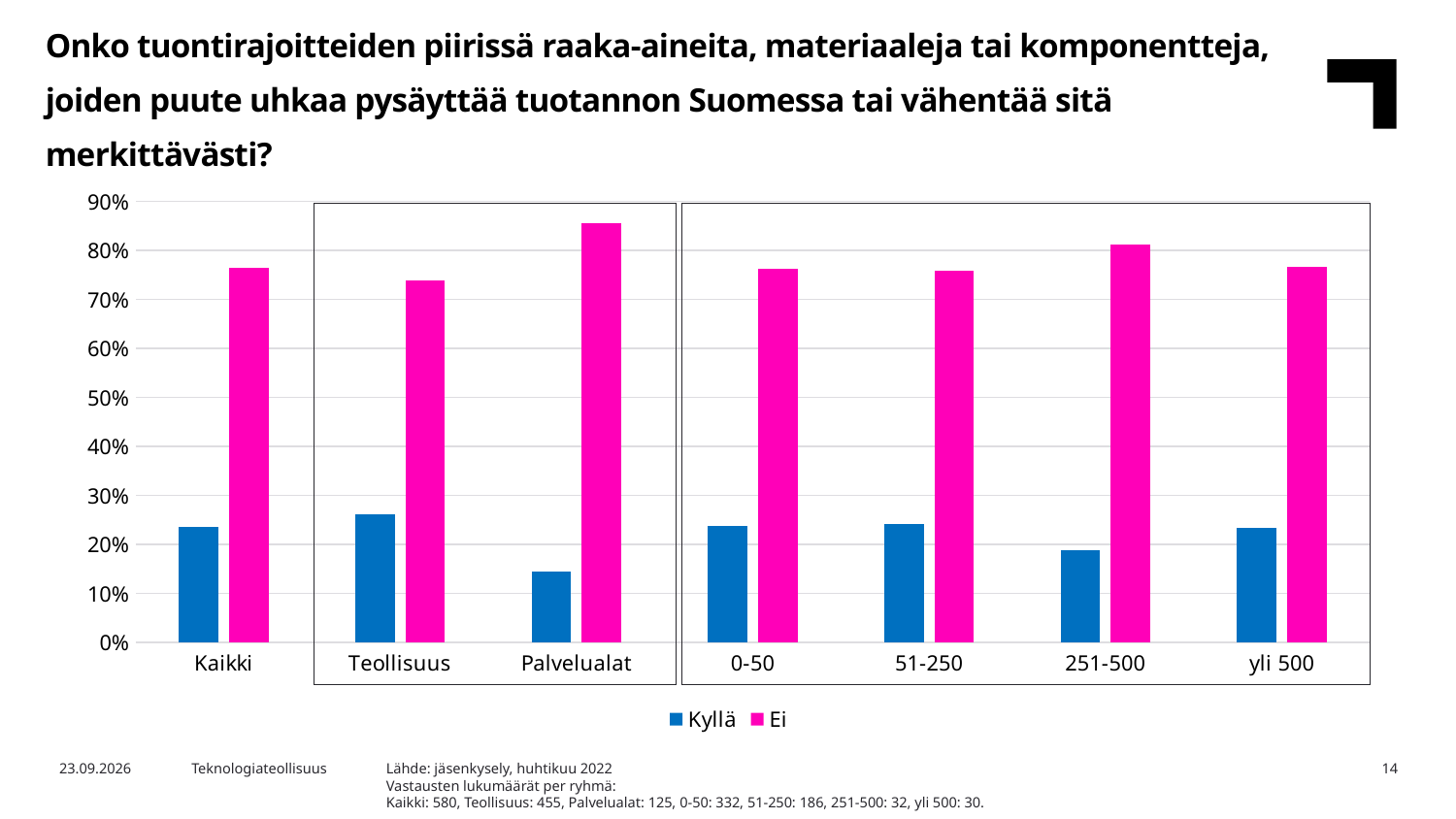
Is the Ei value for 251-500 greater or less than 80%? greater Which category has the highest value for Ei? Palvelualat Which category has the lowest value for Kyllä? Palvelualat What kind of chart is shown on the slide? bar chart How many series does the legend list? 2 Is the Ei value for Palvelualat greater or less than 80%? greater Is the Kyllä value for Teollisuus greater or less than 20%? greater How many categories are shown on the x axis? 7 Which is larger, the Ei value for Palvelualat or the Ei value for Teollisuus? Palvelualat Which series is shown in pink in the legend? Ei